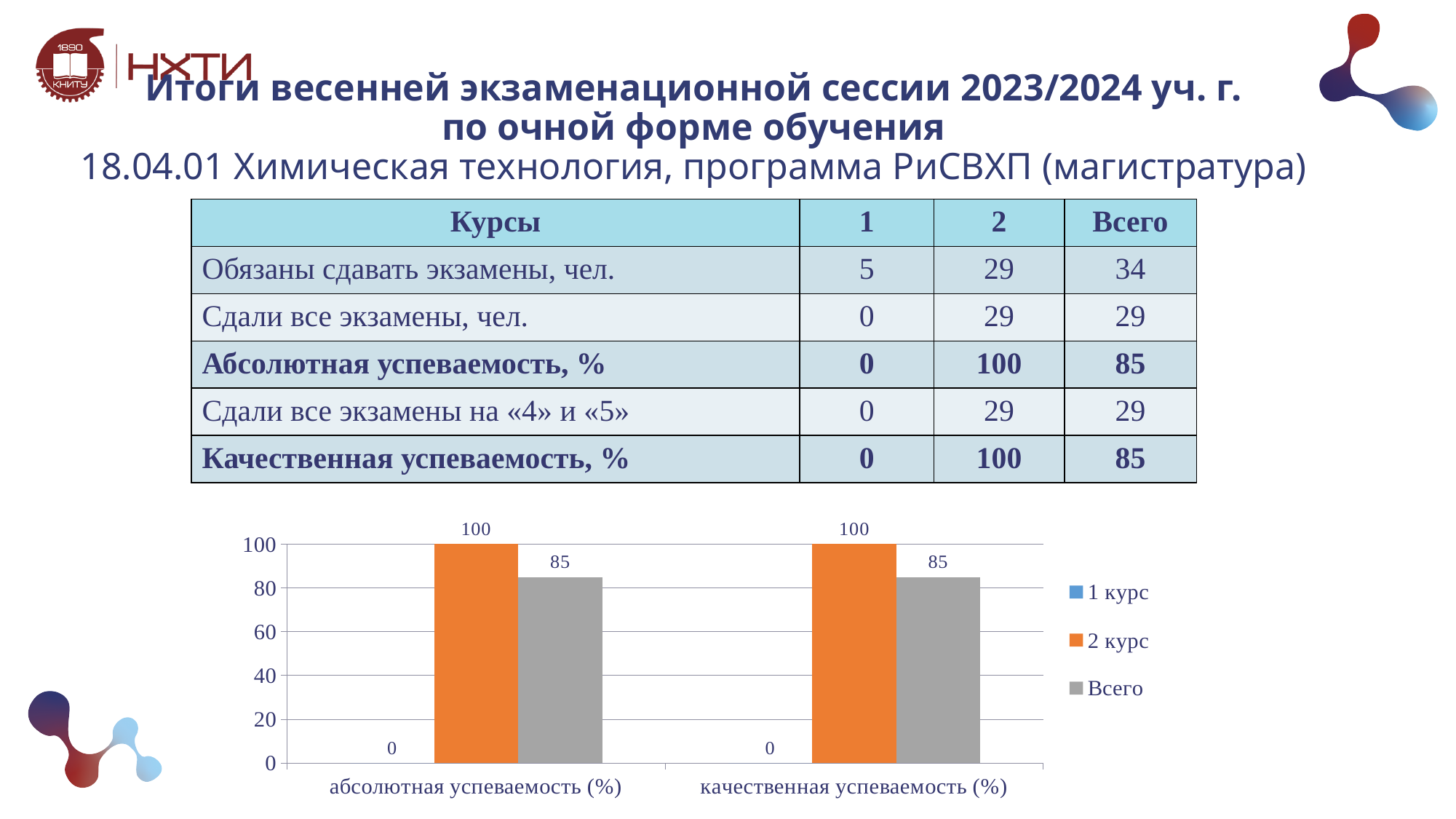
What is the value for "1 курс" in the category "абсолютная успеваемость (%)"? 0 Is the value for "Всего" in the category "абсолютная успеваемость (%)" greater or less than 80? greater In the category "качественная успеваемость (%)", which is larger: the value for "2 курс" or the value for "Всего"? 2 курс What is the value for "2 курс" in the category "абсолютная успеваемость (%)"? 100 How many categories are shown on the x axis of the chart? 2 Which series has the highest value in the category "качественная успеваемость (%)"? 2 курс How many series does the chart legend list? 3 What colour are the bars for the "2 курс" series? orange What is the difference between the "2 курс" and "Всего" values in the category "абсолютная успеваемость (%)"? 15 Which series has the lowest value in the category "абсолютная успеваемость (%)"? 1 курс What is the value for "Всего" in the category "качественная успеваемость (%)"? 85 What type of chart is shown on the slide? bar chart